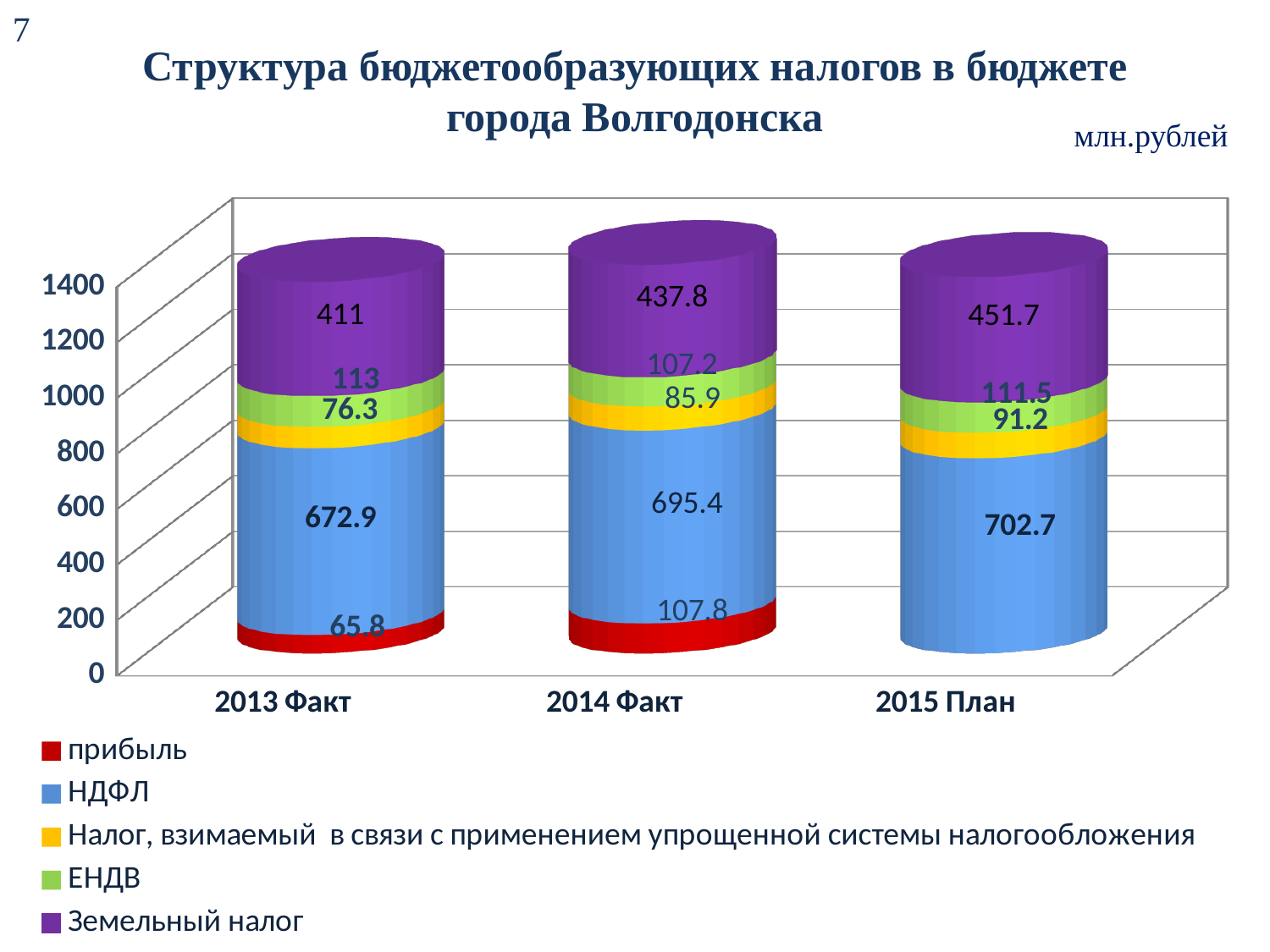
In which year is the value of Земельный налог the lowest? 2013 Факт What is the value of ЕНДВ for 2014 Факт? 107.2 What kind of chart is shown on the slide? Stacked bar chart What is the value of Земельный налог for 2015 План? 451.7 Which is larger: прибыль for 2014 Факт or прибыль for 2013 Факт? 2014 Факт In which year is the value of НДФЛ the highest? 2015 План What is the difference between the НДФЛ values for 2015 План and 2013 Факт? 29.8 What is the total of the stacked bar for 2013 Факт? 1339 What is the value of НДФЛ for 2014 Факт? 695.4 What is the value of прибыль for 2013 Факт? 65.8 How many categories are shown on the x axis? 3 How many series does the legend list? 5